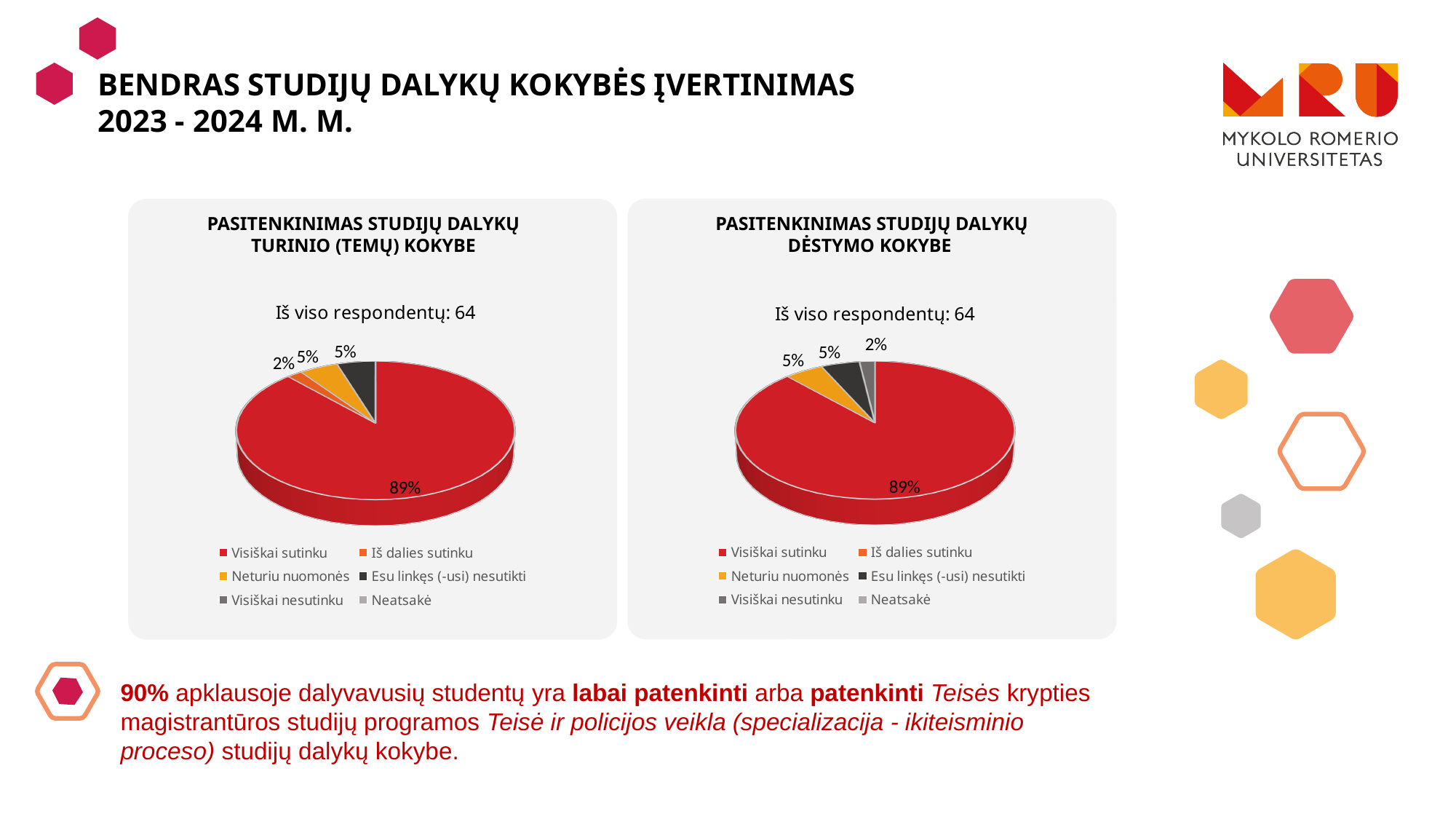
In the left chart, 'Pasitenkinimas studijų dalykų turinio (temų) kokybe', which category has the largest slice? Visiškai sutinku In the right chart, 'Pasitenkinimas studijų dalykų dėstymo kokybe', what share of respondents answered 'Visiškai sutinku'? 89% What kind of chart is used in the left chart, 'Pasitenkinimas studijų dalykų turinio (temų) kokybe'? Pie chart How many entries does the legend of the right chart, 'Pasitenkinimas studijų dalykų dėstymo kokybe', list? 6 In the right chart, 'Pasitenkinimas studijų dalykų dėstymo kokybe', what is the percentage of the smallest slice? 2% In the left chart, 'Pasitenkinimas studijų dalykų turinio (temų) kokybe', what share of respondents answered 'Iš dalies sutinku'? 2% In the left chart, 'Pasitenkinimas studijų dalykų turinio (temų) kokybe', what colour is the 'Visiškai sutinku' slice? Red In the right chart, 'Pasitenkinimas studijų dalykų dėstymo kokybe', what share of respondents answered 'Neturiu nuomonės'? 5% In the left chart, 'Pasitenkinimas studijų dalykų turinio (temų) kokybe', what is the difference between the 'Visiškai sutinku' share and the 'Iš dalies sutinku' share? 87% In the right chart, 'Pasitenkinimas studijų dalykų dėstymo kokybe', how many respondents are there in total? 64